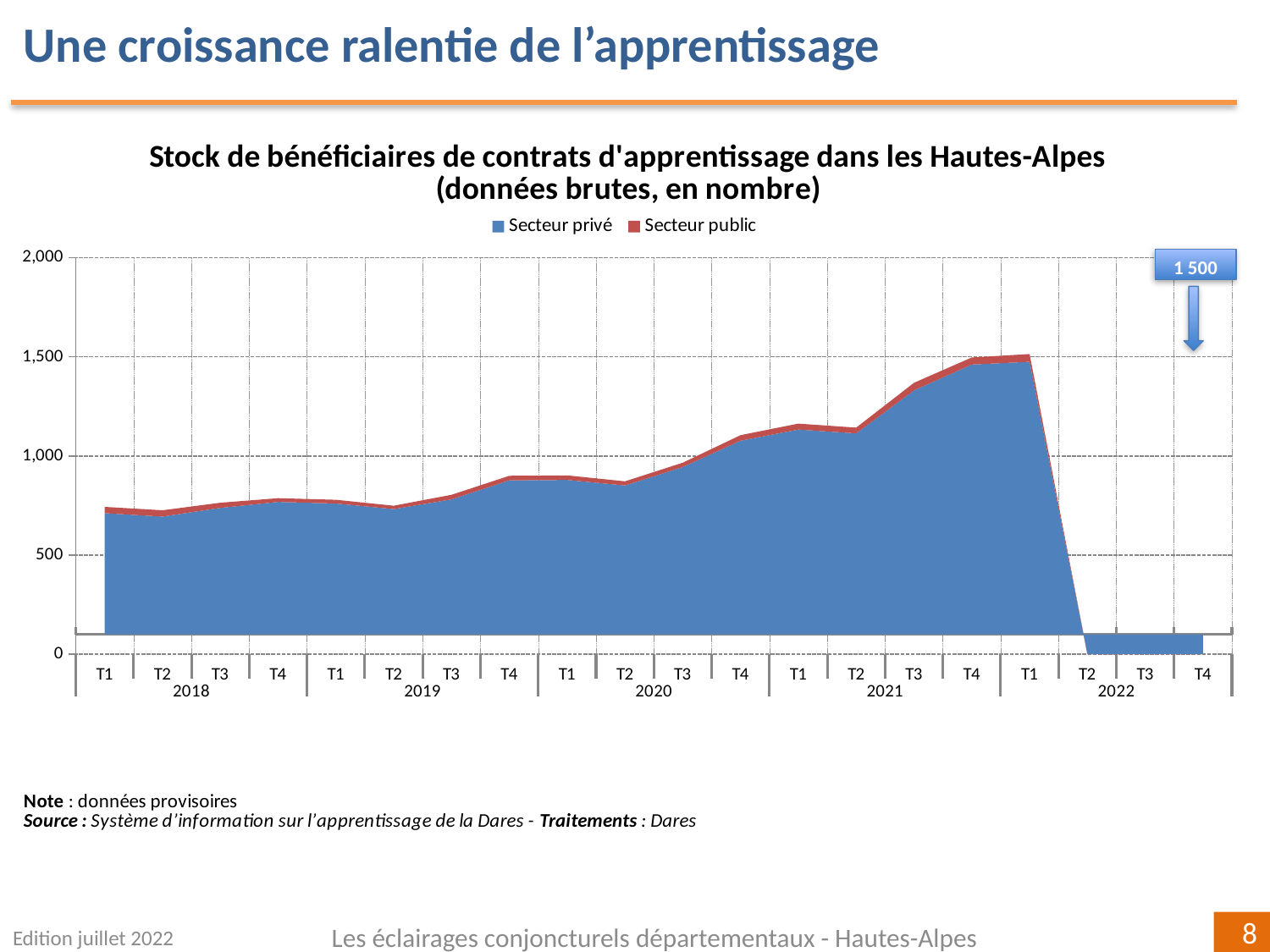
Is the total stock in T4 2020 greater or less than 1,000? greater How many series does the legend list? 2 Which two series are listed in the legend? Secteur privé and Secteur public How many quarters are shown along the x axis? 20 Is the total stock in T1 2022 greater or less than 1,000? greater Is the total stock in T1 2018 greater or less than 1,000? less What kind of chart is shown on the slide? Area chart What colour represents the Secteur privé series? Blue Which is larger, the total stock in T1 2022 or in T1 2018? T1 2022 Does the total stock generally rise or fall from T1 2018 to T1 2022? Rise